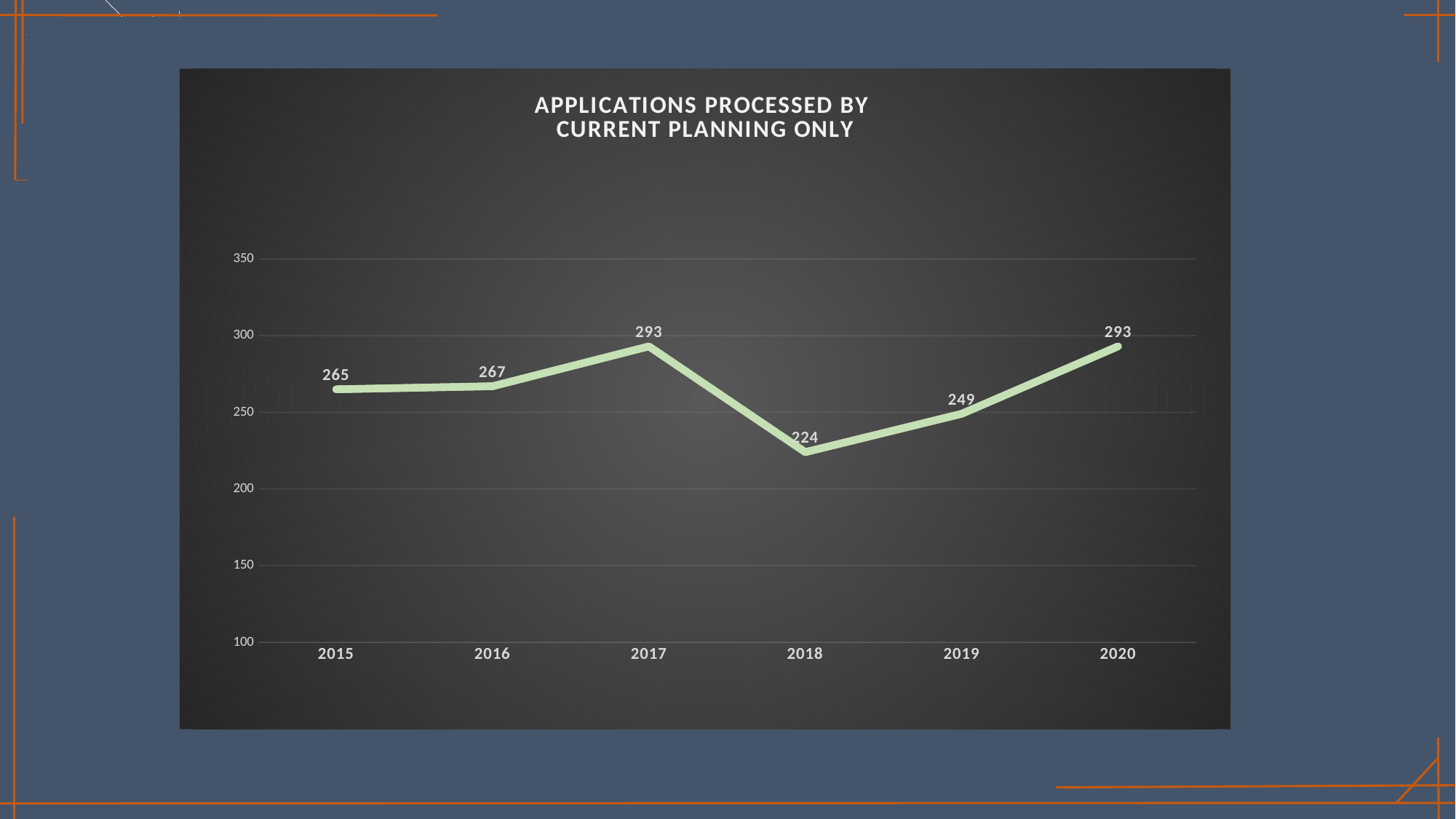
Which is larger, the value for 2019 or the value for 2016? 2016 What is the difference between the values for 2017 and 2018? 69 Do the values rise or fall from 2018 to 2020? rise What is the value for 2018? 224 Is the value for 2018 greater or less than 250? less Which year has the lowest value? 2018 What is the title of the chart? Applications Processed by Current Planning Only What kind of chart is shown? line chart What is the value for 2019? 249 What is the value for 2015? 265 How many years are plotted on the chart? 6 What is the difference between the values for 2016 and 2015? 2